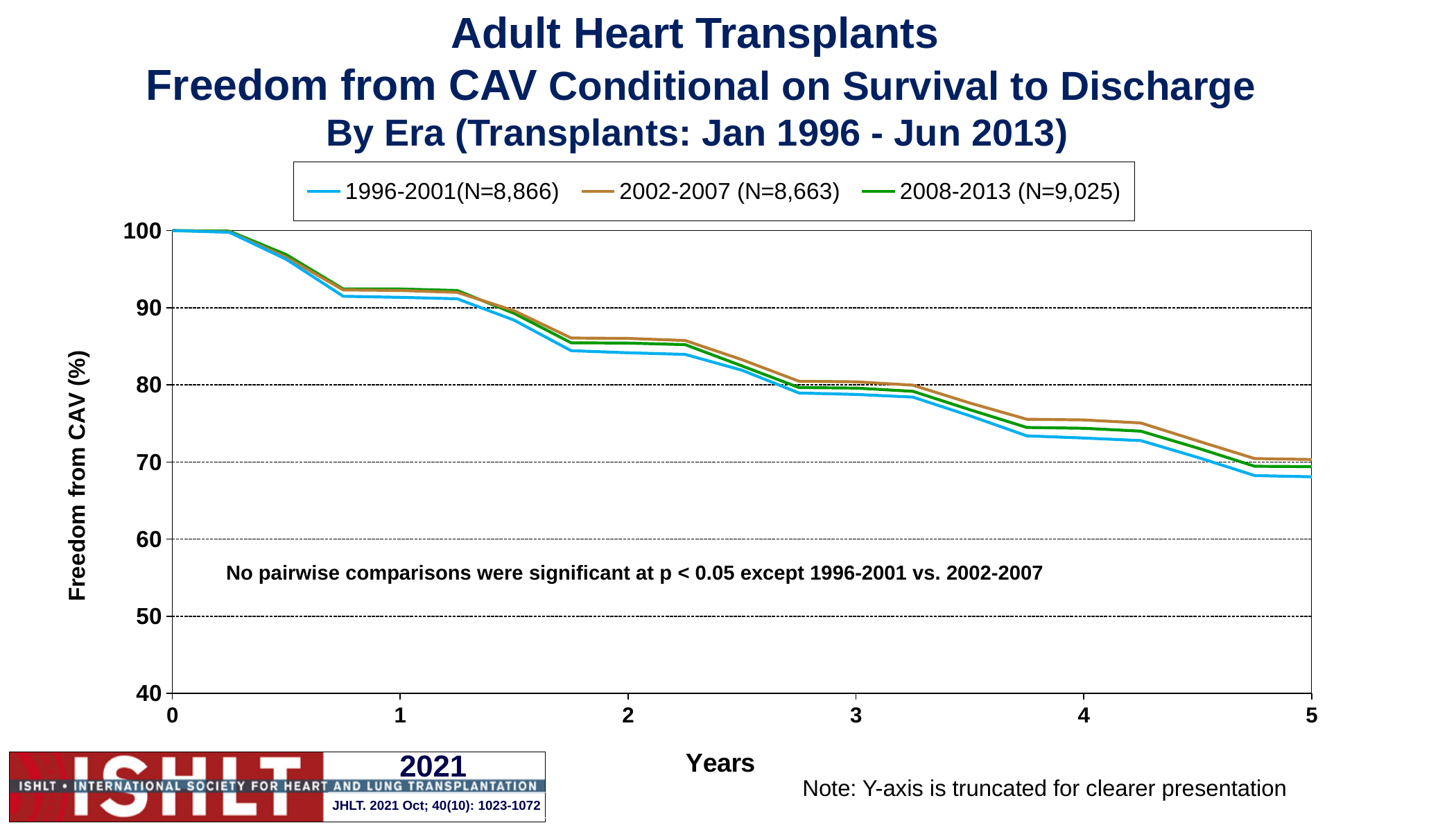
What kind of chart is shown on the slide? line chart Is the value for 2008-2013 at year 4 greater or less than 70? greater Is the value for 1996-2001 at year 4 greater or less than 80? less How many series does the legend list? 3 Is the value for 1996-2001 at year 5 greater or less than 70? less At year 5, which era has the lowest freedom from CAV? 1996-2001 Do the freedom from CAV values rise or fall as years increase? fall What is the label of the y-axis? Freedom from CAV (%) What is the freedom from CAV value for all three eras at year 0? 100 At year 5, which is higher: the value for 1996-2001 or the value for 2002-2007? 2002-2007